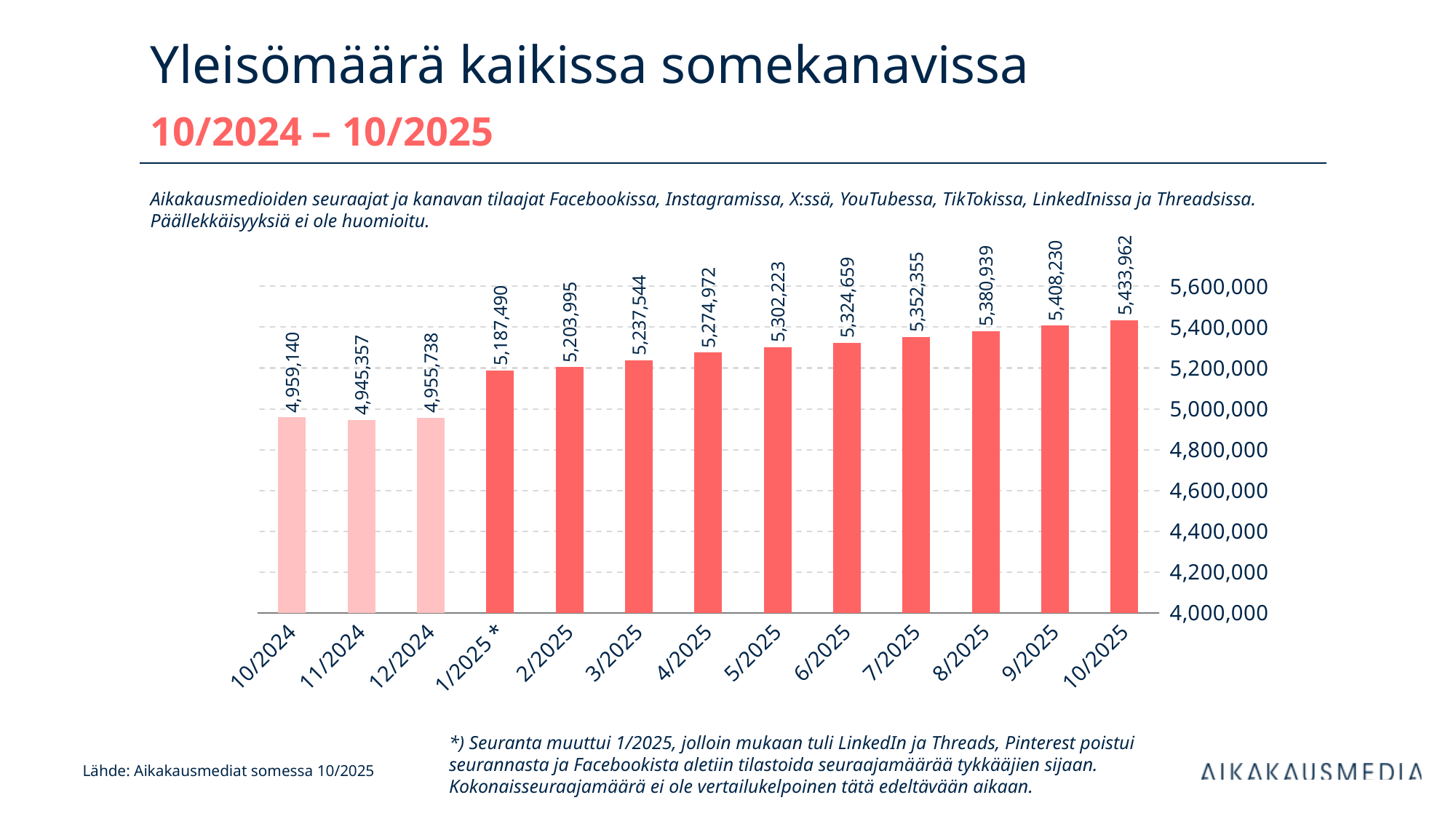
What is the difference between the values for 10/2025 and 9/2025? 25,732 Is the value for 12/2024 greater or less than 5,000,000? less Which is larger, the value for 5/2025 or the value for 4/2025? 5/2025 What is the value for 10/2025? 5,433,962 Do the values rise or fall from 1/2025 * to 10/2025? rise What is the value for 1/2025 *? 5,187,490 What is the difference between the values for 1/2025 * and 12/2024? 231,752 Which month has the lowest value? 11/2024 What is the value for 10/2024? 4,959,140 How many months are shown on the x axis? 13 Which month has the highest value? 10/2025 What kind of chart is shown on the slide? bar chart